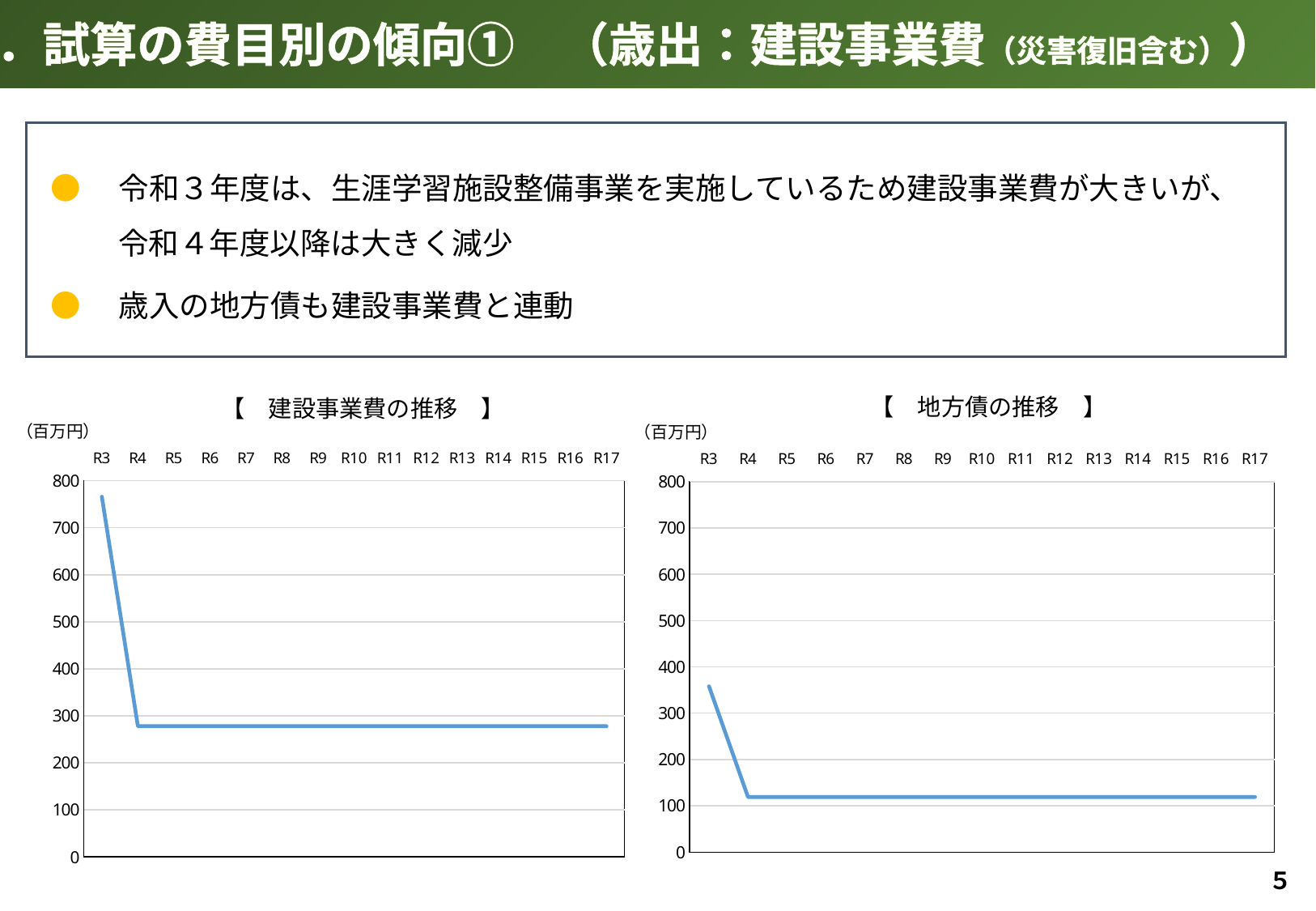
What unit is shown above the y axis of the 地方債の推移 chart? 百万円 In the 地方債の推移 chart, which year has the highest value? R3 In the 地方債の推移 chart, is the value for R12 greater or less than 200? less What kind of chart is the 地方債の推移 chart on the right? line chart In the 建設事業費の推移 chart, is the value for R3 greater or less than 700? greater In the 建設事業費の推移 chart, do the values rise or fall from R3 to R4? fall In the 建設事業費の推移 chart, how many years (points) are plotted along the x axis? 15 In the 建設事業費の推移 chart, which year has the highest value? R3 In the 地方債の推移 chart, how many years (points) are plotted along the x axis? 15 In the 地方債の推移 chart, is the value for R3 greater or less than 300? greater What kind of chart is the 建設事業費の推移 chart on the left? line chart